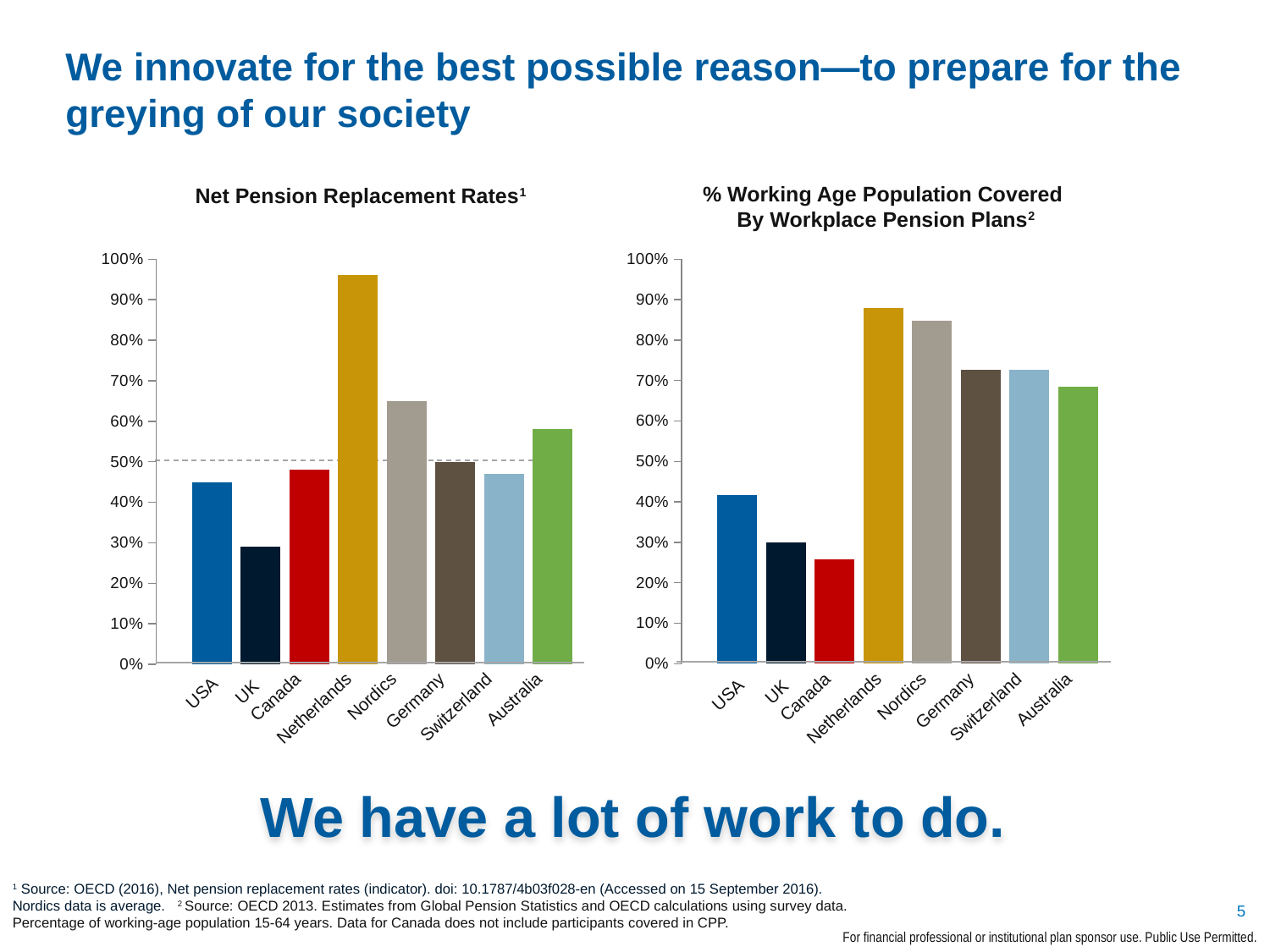
In the 'Net Pension Replacement Rates' chart, which country has the highest value? Netherlands In the 'Net Pension Replacement Rates' chart, which is larger, the value for Nordics or the value for Australia? Nordics In the 'Net Pension Replacement Rates' chart, which country has the lowest value? UK In the 'Net Pension Replacement Rates' chart, is the value for Nordics greater or less than 60%? greater At what level is the horizontal dashed line drawn on the 'Net Pension Replacement Rates' chart? 50% In the '% Working Age Population Covered By Workplace Pension Plans' chart, is the value for Germany greater or less than 70%? greater What kind of chart is the 'Net Pension Replacement Rates' chart on the left? bar chart How many countries or regions are shown on the x axis of the 'Net Pension Replacement Rates' chart? 8 In the 'Net Pension Replacement Rates' chart, is the value for USA greater or less than 50%? less In the '% Working Age Population Covered By Workplace Pension Plans' chart, which is larger, the value for USA or the value for UK? USA In the '% Working Age Population Covered By Workplace Pension Plans' chart, which country has the lowest value? Canada